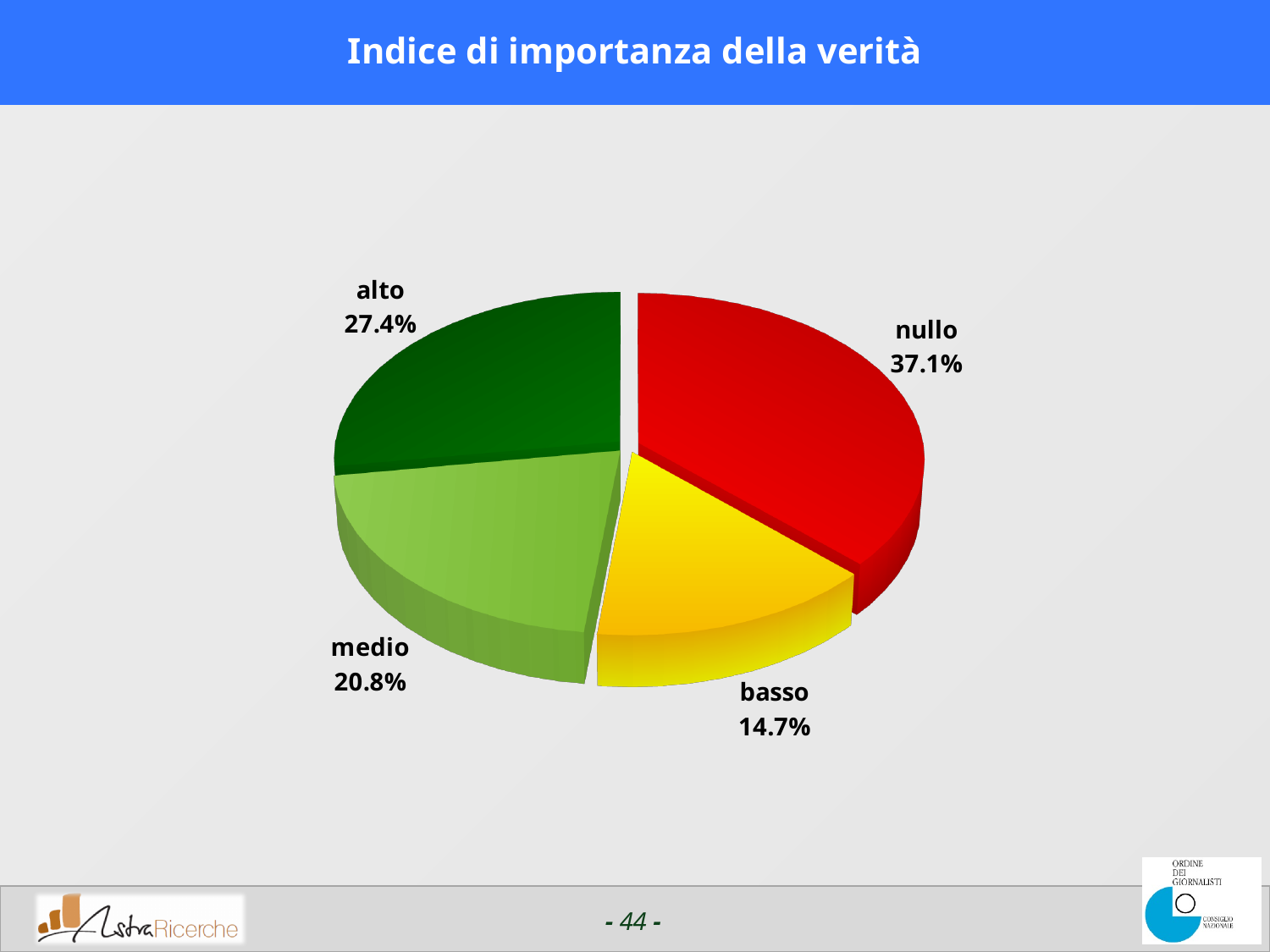
What is the title of the chart? Indice di importanza della verità What colour is the 'nullo' slice? red Which category has the smallest share of the pie? basso Which category has the largest share of the pie? nullo What percentage is shown for the 'nullo' slice? 37.1% How many slices does the pie chart have? 4 What percentage is shown for the 'basso' slice? 14.7% Which is larger, the share for 'medio' or the share for 'basso'? medio What is the difference in percentage points between 'nullo' and 'alto'? 9.7 What percentage is shown for the 'alto' slice? 27.4% What type of chart is shown on the slide? pie chart What percentage is shown for the 'medio' slice? 20.8%